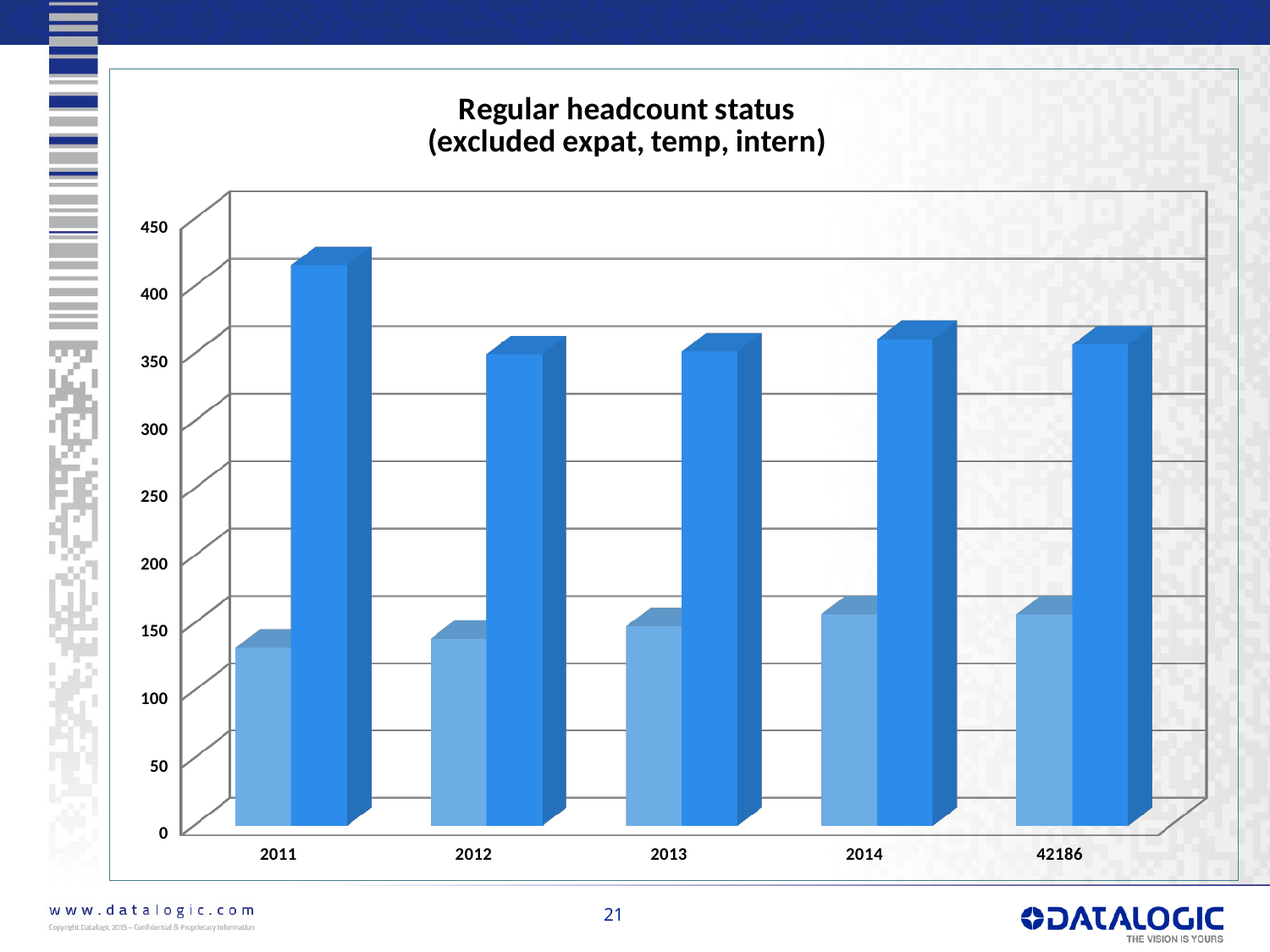
Is the dark blue bar for 2014 greater or less than 400? less How many categories are shown along the x axis? 5 How many bars are plotted for each category? 2 What kind of chart is shown on the slide? bar chart Which category has the tallest dark blue bar? 2011 Is the light blue bar for 2011 greater or less than 150? less Which category has the shortest light blue bar? 2011 Is the light blue bar for 2011 greater or less than 100? greater What is the title of the chart? Regular headcount status (excluded expat, temp, intern) Do the light blue bars rise or fall from 2011 to 2014? rise Which is larger, the dark blue bar for 2011 or the dark blue bar for 2012? 2011